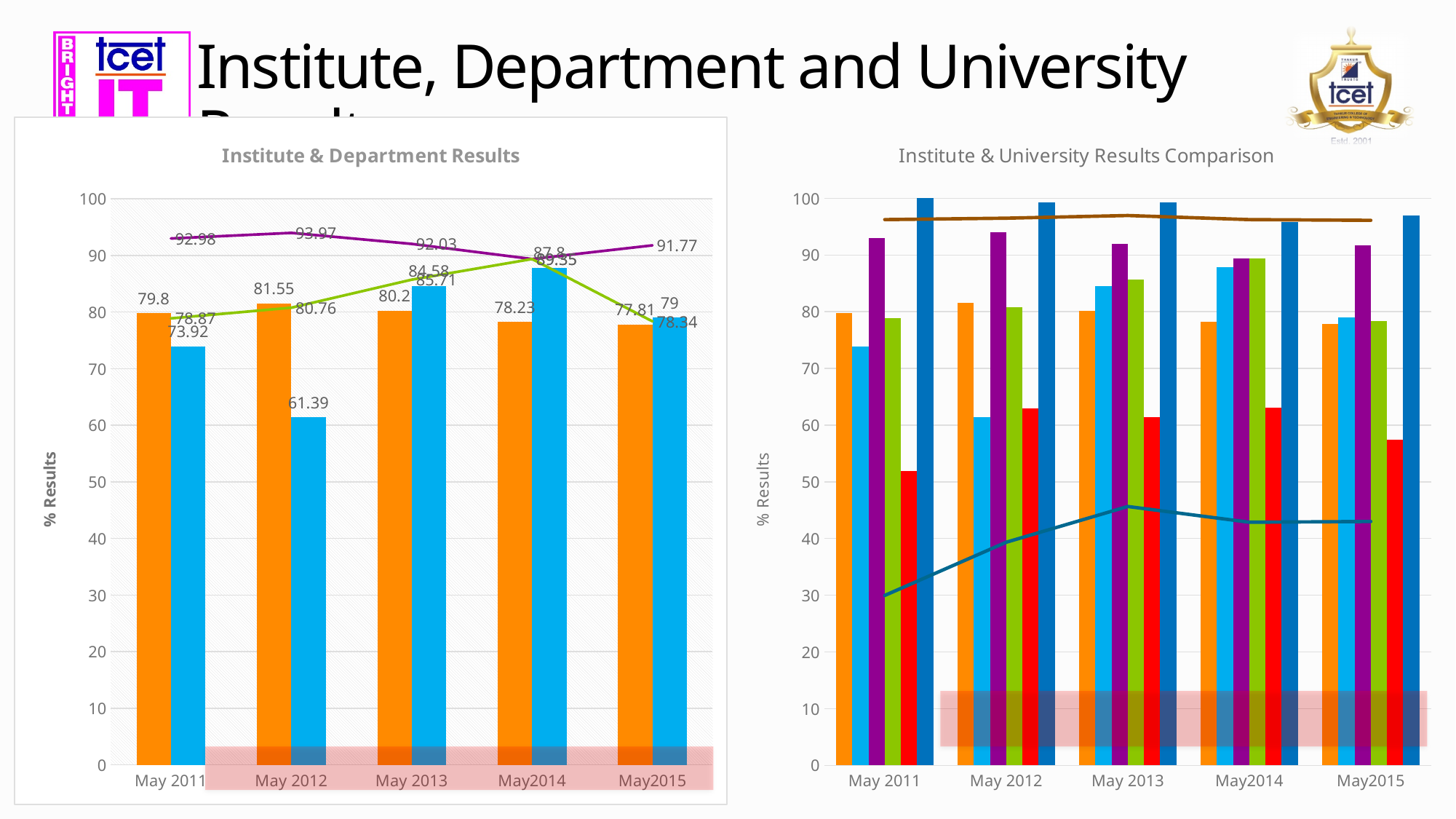
In the 'Institute & University Results Comparison' chart, is the value of the red bar for May 2011 greater or less than 60? less In the 'Institute & Department Results' chart, what is the value of the blue bar for May 2012? 61.39 In the 'Institute & Department Results' chart, what is the value of the orange bar for May 2012? 81.55 In the 'Institute & Department Results' chart, do the orange bars rise or fall from May 2012 to May2015? fall In the 'Institute & Department Results' chart, how many years are shown on the x axis? 5 In the 'Institute & Department Results' chart, for May 2013, which is larger: the orange bar or the blue bar? the blue bar What is the title of the chart on the right side of the slide? Institute & University Results Comparison In the 'Institute & Department Results' chart, in which year is the blue bar lowest? May 2012 In the 'Institute & University Results Comparison' chart, is the value of the dark blue bar for May 2011 greater or less than 90? greater In the 'Institute & Department Results' chart, in which year is the orange bar highest? May 2012 In the 'Institute & Department Results' chart, what is the value of the blue bar for May 2013? 84.58 In the 'Institute & Department Results' chart, what is the difference between the orange bar and the blue bar for May 2012? 20.16